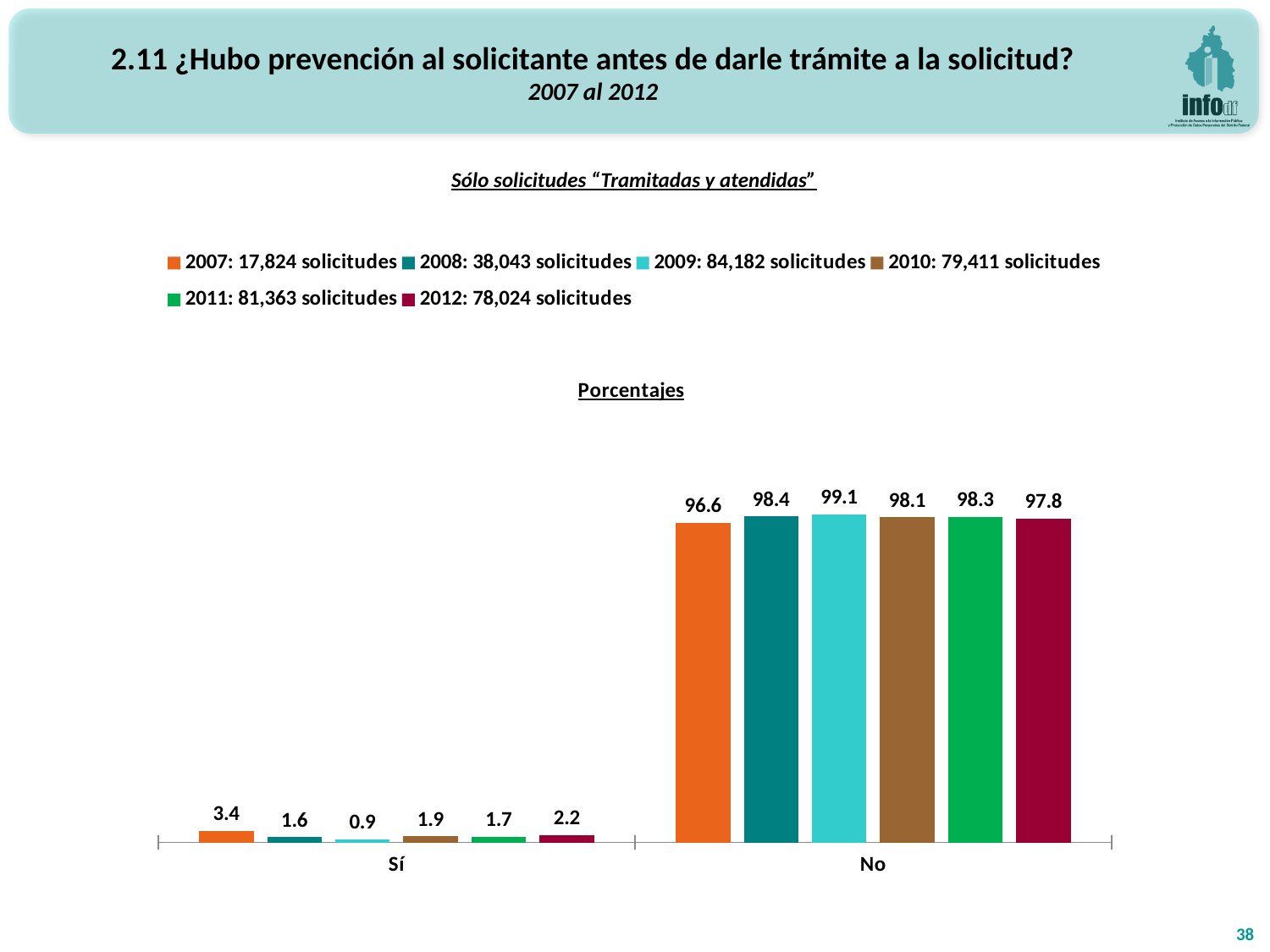
Which year has the lowest value in the "Sí" category? 2009 What is the difference between the 2007 and 2009 values in the "Sí" category? 2.5 What kind of chart is shown on the slide? Bar chart How many series does the legend list? 6 Which is larger in the "Sí" category: the value for 2010 or the value for 2011? 2010 What is the value for 2012 in the "Sí" category? 2.2 What is the difference between the 2009 and 2007 values in the "No" category? 2.5 Which year has the lowest value in the "No" category? 2007 How many categories are shown on the x axis? 2 What is the value for 2007 in the "Sí" category? 3.4 Which year has the highest value in the "Sí" category? 2007 What is the value for 2009 in the "No" category? 99.1